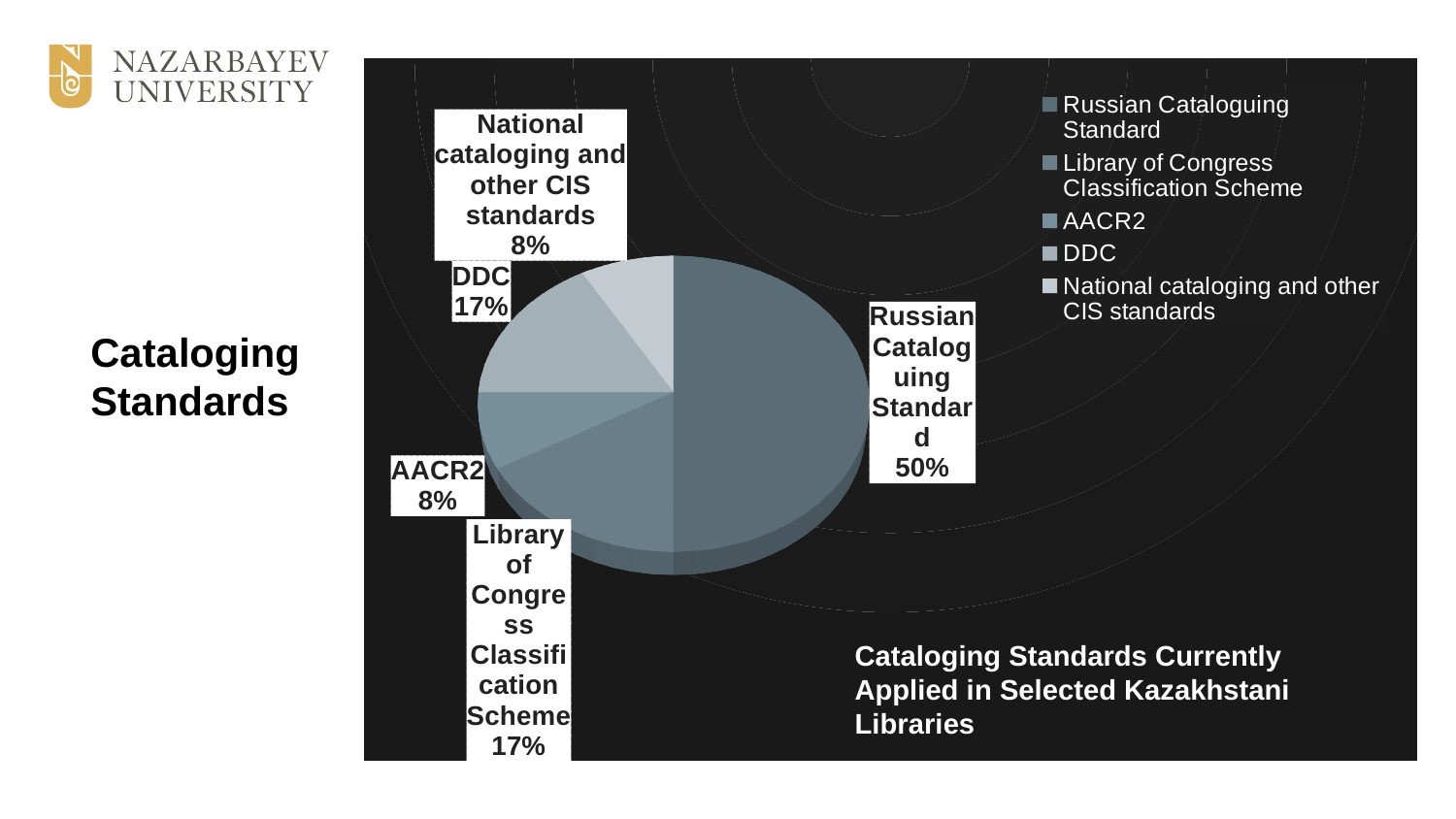
Which is larger, the share for DDC or the share for AACR2? DDC How many slices does the pie chart have? 5 What share of the pie does AACR2 have? 8% What share of the pie does National cataloging and other CIS standards have? 8% What kind of chart is shown on the slide? Pie chart Which category has the largest slice of the pie? Russian Cataloguing Standard What share of the pie does Russian Cataloguing Standard have? 50% What share of the pie does Library of Congress Classification Scheme have? 17% How many entries does the legend list? 5 What share of the pie does DDC have? 17% What is the difference in percentage points between Russian Cataloguing Standard and DDC? 33 What is the title of the chart? Cataloging Standards Currently Applied in Selected Kazakhstani Libraries